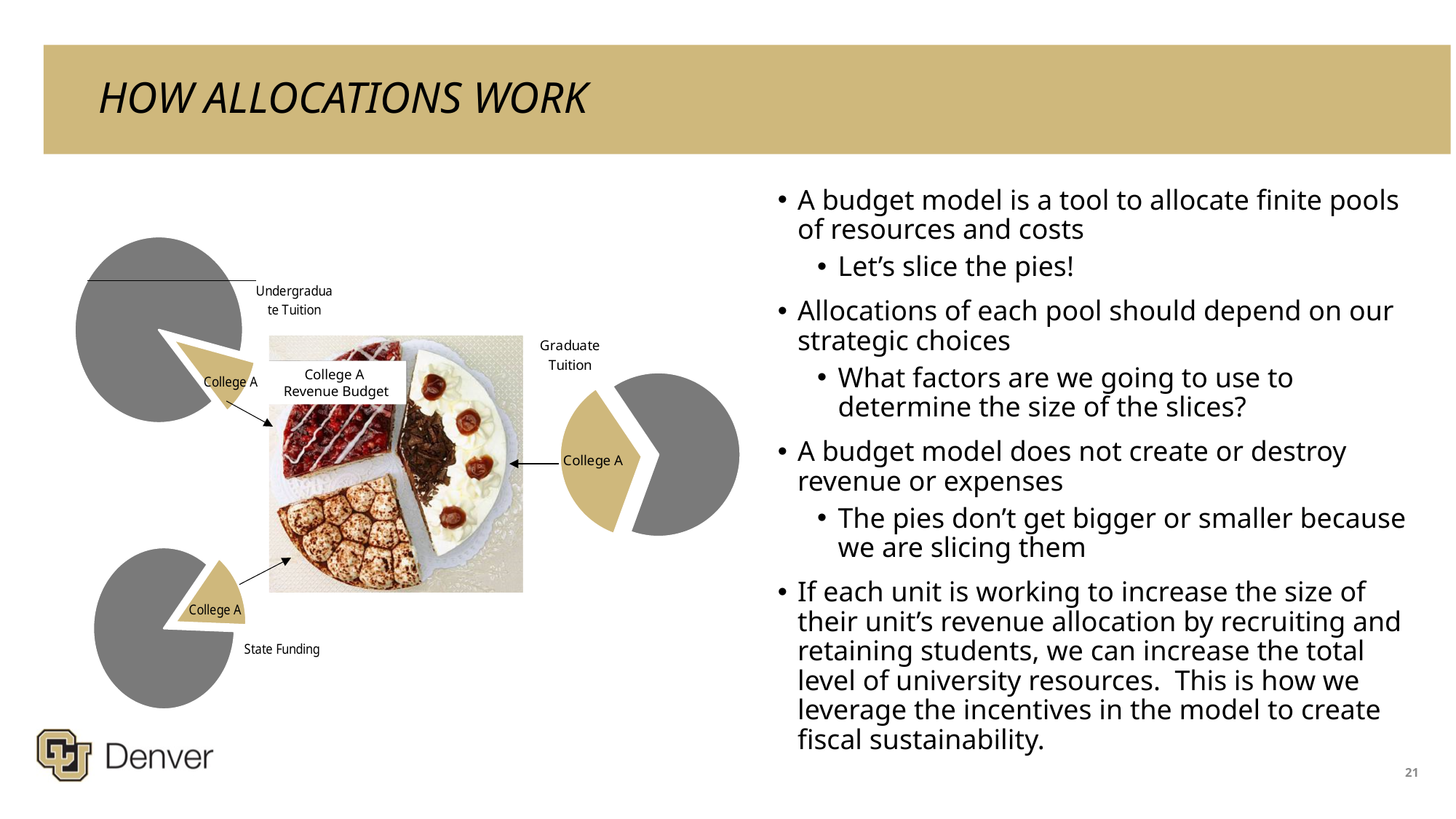
Which of the three pie charts shows the largest College A slice? Graduate Tuition In the State Funding pie chart, is the College A slice larger or smaller than the grey slice? Smaller How many pie charts are shown on the slide? 3 How many slices does the Graduate Tuition pie chart have? 2 What kind of chart is the Undergraduate Tuition chart? Pie chart In the Undergraduate Tuition pie chart, which slice is larger: the College A slice or the grey remainder? The grey remainder What colour is the College A slice in each pie chart? Gold In the Graduate Tuition pie chart, which slice is the smallest? College A What kind of chart is the State Funding chart? Pie chart What is the label of the pulled-out slice in the State Funding pie chart? College A What are the titles of the three pie charts on the slide? Undergraduate Tuition, Graduate Tuition, State Funding